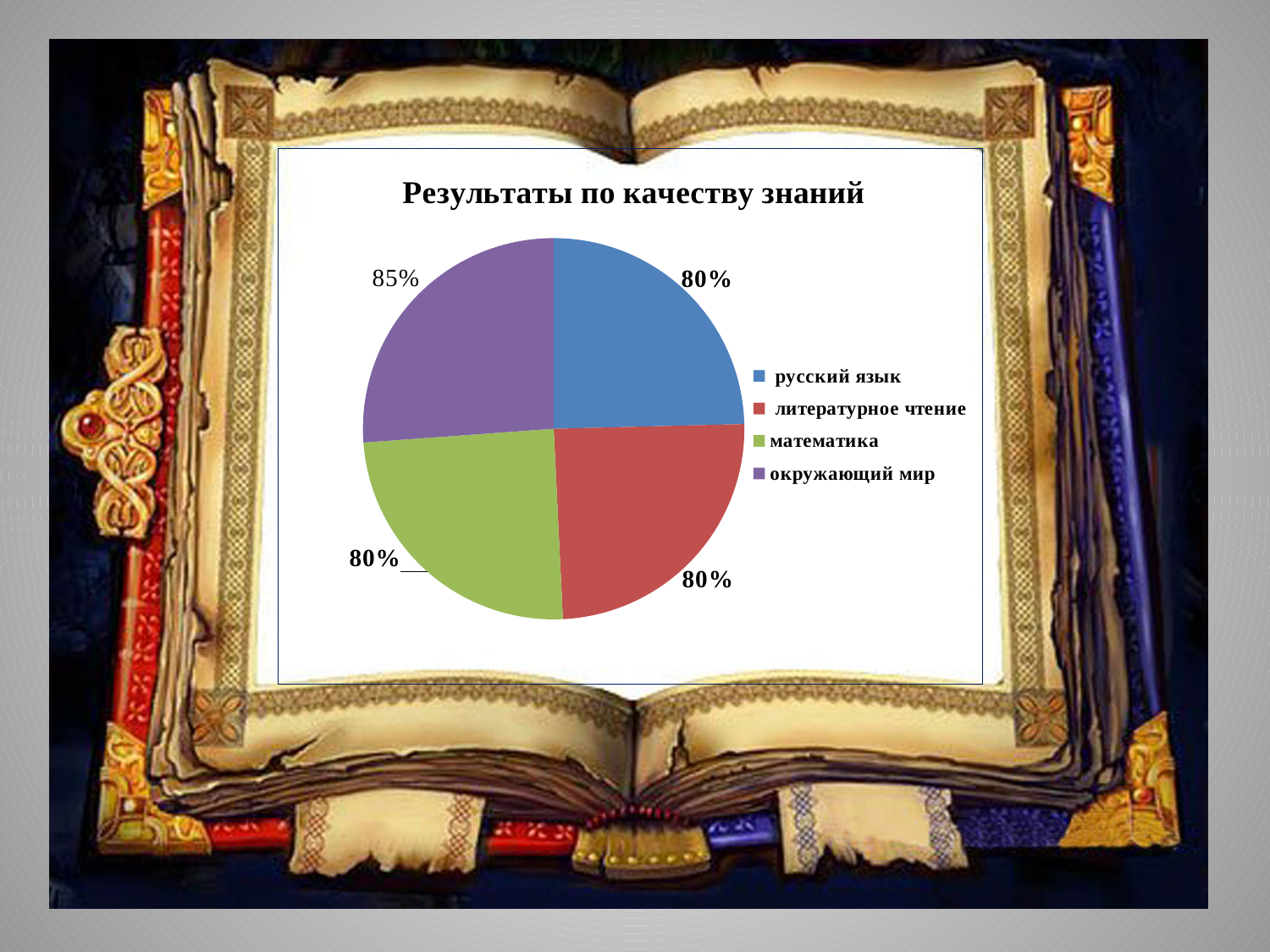
What value is shown for окружающий мир? 85% How many entries does the legend list? 4 What is the difference between the values for окружающий мир and русский язык? 5% What value is shown for математика? 80% What is the title of the chart? Результаты по качеству знаний What value is shown for русский язык? 80% Which is larger, the value for окружающий мир or the value for математика? окружающий мир Which colour represents математика in the chart? green What value is shown for литературное чтение? 80% Which subject has the highest value? окружающий мир How many slices does the pie chart have? 4 What kind of chart is shown on the slide? pie chart